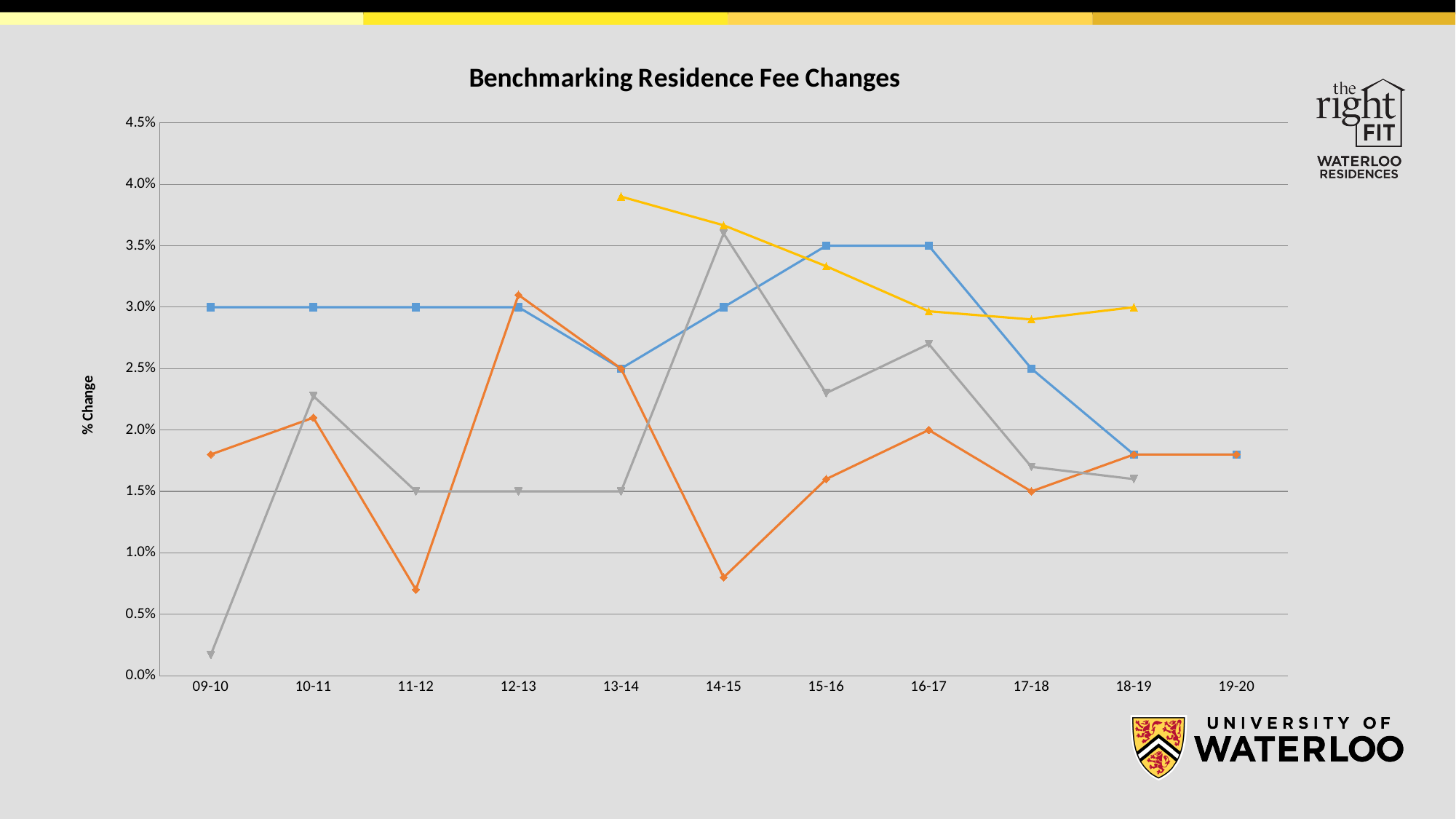
What is the value of the blue line for 17-18? 2.5% What type of chart is shown on the slide? line chart What is the title of the chart? Benchmarking Residence Fee Changes What is the value of the gray line for 12-13? 1.5% How many academic-year categories are shown on the x axis? 11 Is the value of the gray line for 09-10 greater or less than 0.5%? less What is the label on the vertical axis of the chart? % Change Does the yellow line rise or fall from 13-14 to 17-18? fall Is the value of the yellow line for 13-14 greater or less than 3.5%? greater What is the difference between the blue line's value for 16-17 and its value for 17-18? 1.0% At 14-15, which line has the larger value, the blue line or the orange line? blue line What is the value of the blue line for 15-16? 3.5%